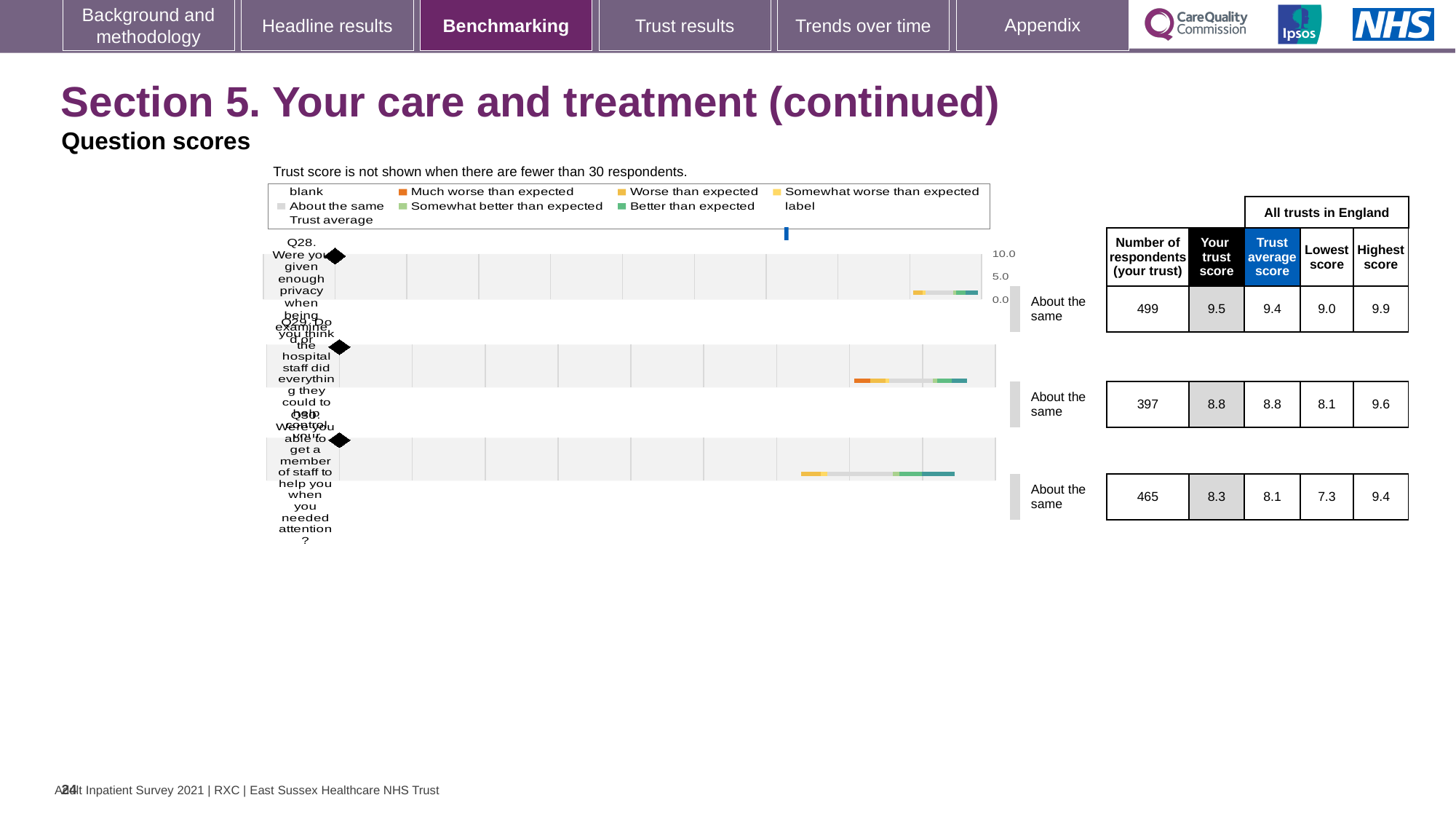
What is the 'Trust average score' for Q30? 8.1 Which question (Q28, Q29 or Q30) has the highest 'Your trust score'? Q28 What benchmark category is shown next to the chart for Q29? About the same What is the 'Lowest score' across all trusts in England for Q29? 8.1 How many respondents from your trust answered Q30? 465 What kind of chart is used to show the question scores? Bar chart Which question (Q28, Q29 or Q30) has the lowest 'Your trust score'? Q30 What is the 'Your trust score' value for Q28? 9.5 Is the 'Your trust score' for Q28 greater or less than 5.0 on the chart axis? greater What is the difference between the 'Your trust score' for Q28 and for Q30? 1.2 How many questions are plotted on this slide? 3 For Q30, which is larger: 'Your trust score' or 'Trust average score'? Your trust score